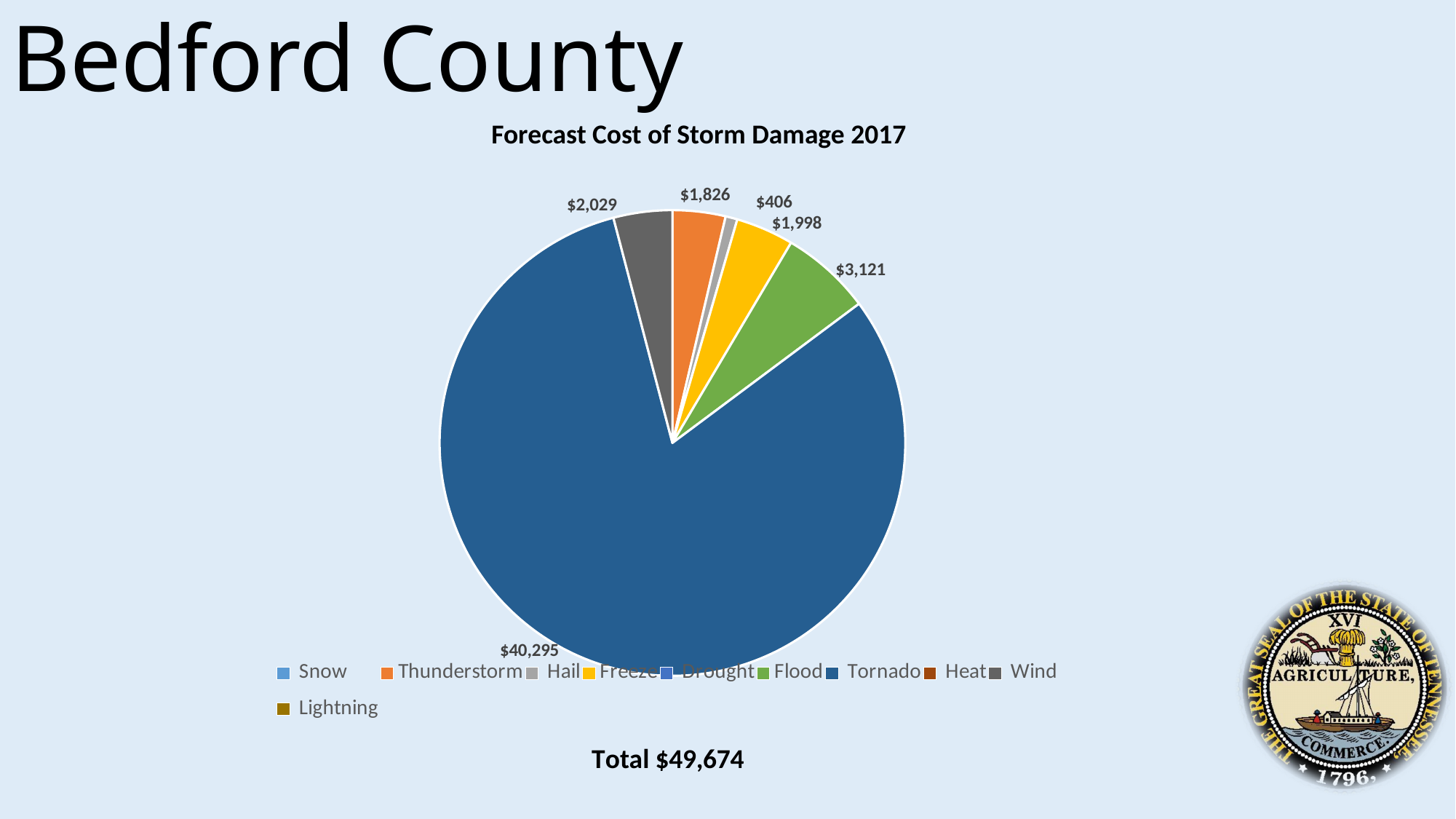
Which labelled slice has the lowest forecast cost of damage? Hail What is the forecast cost of storm damage from Flood? $3,121 Which has a larger forecast cost, Freeze or Thunderstorm? Freeze What is the forecast cost of storm damage from Thunderstorm? $1,826 What is the forecast cost of storm damage from Wind? $2,029 Which storm type has the highest forecast cost of damage? Tornado What is the forecast cost of storm damage from Hail? $406 What is the forecast cost of storm damage from Tornado? $40,295 What is the difference between the forecast cost for Flood and for Wind? $1,092 How many categories does the legend list? 10 What kind of chart is shown on the slide? pie chart What is the title of the chart? Forecast Cost of Storm Damage 2017